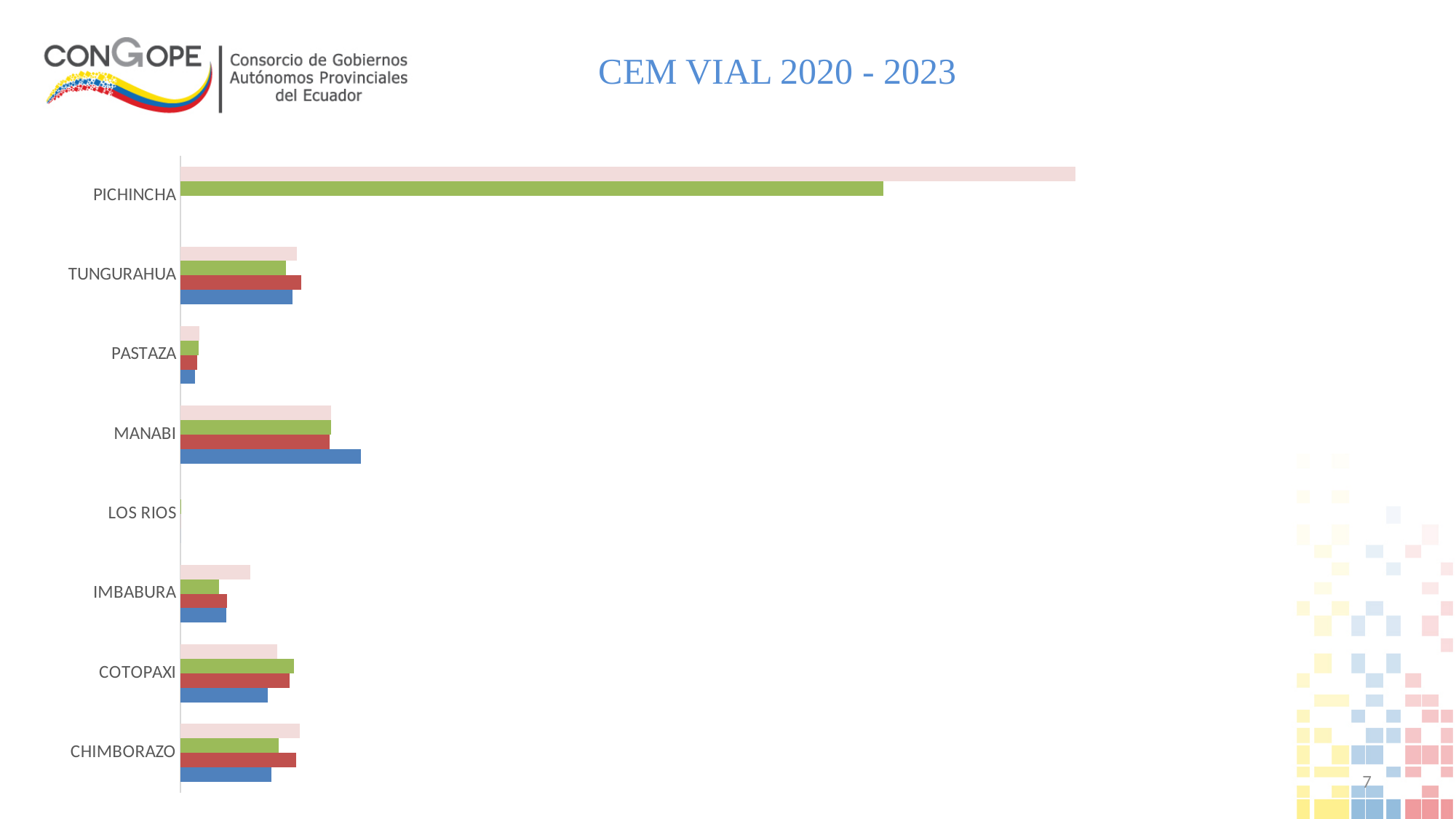
How many provinces (categories) are listed on the chart's vertical axis? 8 What is the title of the chart on the slide? CEM VIAL 2020 - 2023 Which province has longer bars, PICHINCHA or PASTAZA? PICHINCHA For PICHINCHA, which bar is longer, the pink one or the green one? the pink one What kind of chart is shown on the slide? bar chart Which province is listed at the top of the chart's vertical axis? PICHINCHA Which province has a longer blue bar, MANABI or PASTAZA? MANABI Which province has the shortest bars on the chart? LOS RIOS Which province has the longest bar on the chart? PICHINCHA